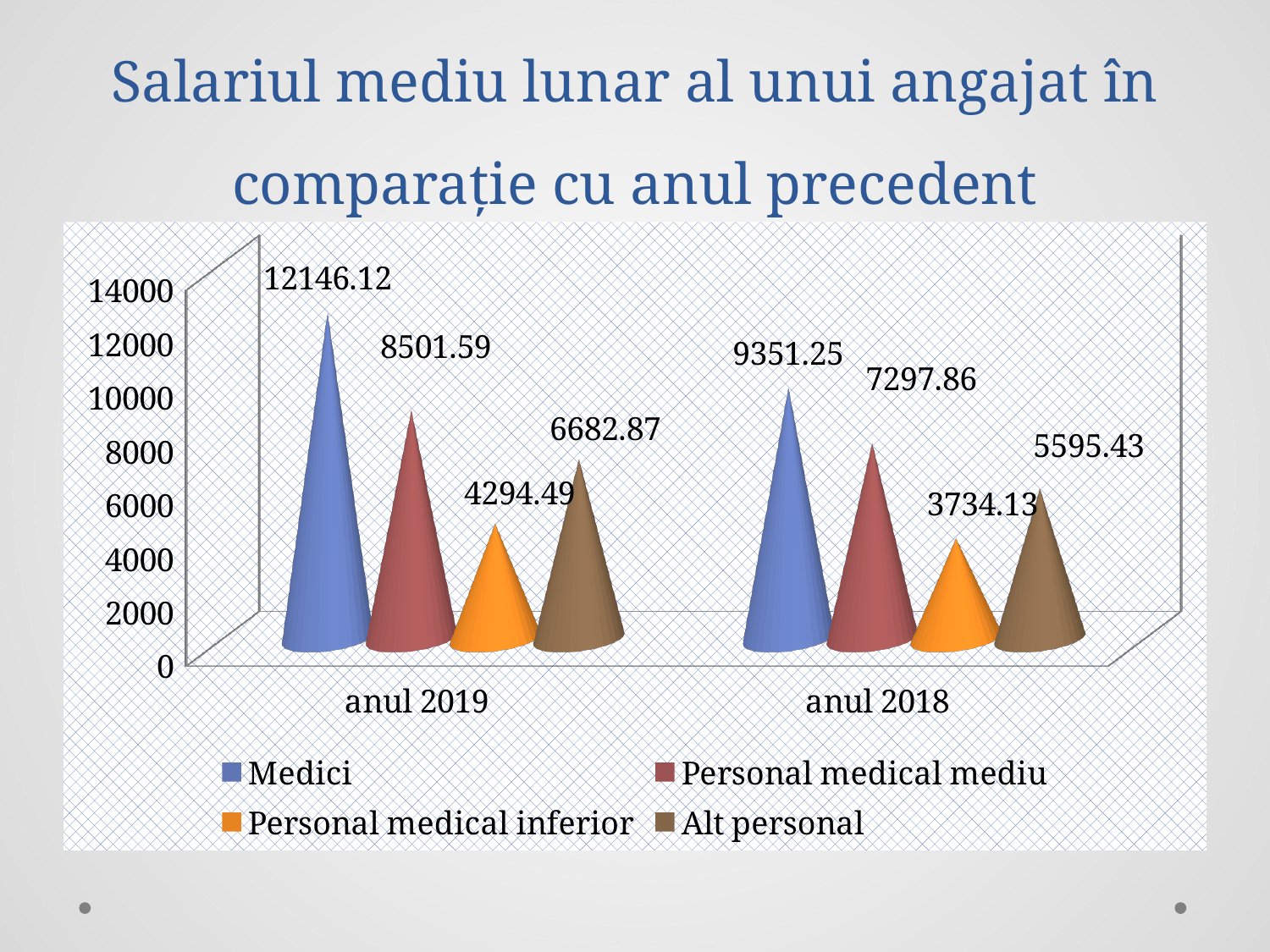
What is the difference between the Medici value in anul 2019 and in anul 2018? 2794.87 What is the value for Personal medical inferior in anul 2018? 3734.13 Which series has the highest value in anul 2018? Medici How many categories are shown on the x axis? 2 Which series has the lowest value in anul 2019? Personal medical inferior What is the value for Personal medical mediu in anul 2018? 7297.86 What is the difference between the Alt personal value in anul 2019 and in anul 2018? 1087.44 What is the value for Medici in anul 2019? 12146.12 What is the value for Alt personal in anul 2019? 6682.87 What kind of chart is shown on the slide? Bar chart Which is larger: Personal medical mediu in anul 2019 or Medici in anul 2018? Medici in anul 2018 How many series does the legend list? 4